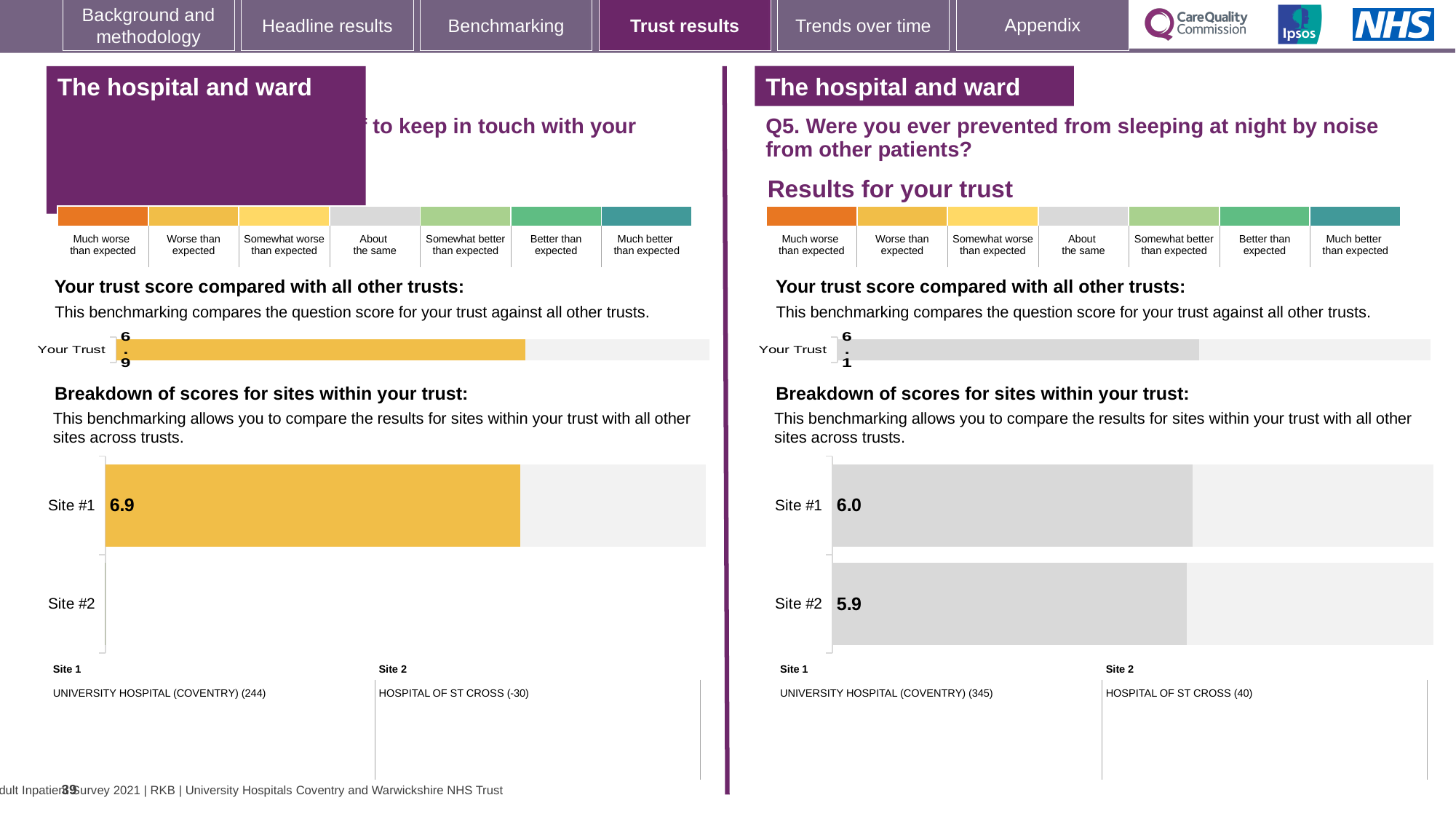
Which site name is listed as Site 1 beneath the right-hand Q5 chart? UNIVERSITY HOSPITAL (COVENTRY) (345) What colour is the Site #1 bar on the left-hand site breakdown chart? yellow On the right-hand site breakdown chart for Q5, which site has the higher score? Site #1 What type of chart is used for the site breakdown on the right-hand side of the slide? bar chart Is the Site #1 score on the left-hand site breakdown chart larger or smaller than the Site #1 score on the right-hand Q5 chart? larger How many sites are listed on the right-hand site breakdown chart for Q5? 2 On the right-hand 'Your trust score compared with all other trusts' chart for Q5, what is the score shown for Your Trust? 6.1 On the right-hand chart for Q5, what is the score for Site #2? 5.9 On the right-hand chart for Q5 (prevented from sleeping at night by noise from other patients), what is the score for Site #1? 6.0 On the right-hand site breakdown chart for Q5, what is the difference between the Site #1 and Site #2 scores? 0.1 On the left-hand site breakdown chart, what is the score for Site #1? 6.9 On the left-hand 'Your trust score compared with all other trusts' chart, what is the score shown for Your Trust? 6.9